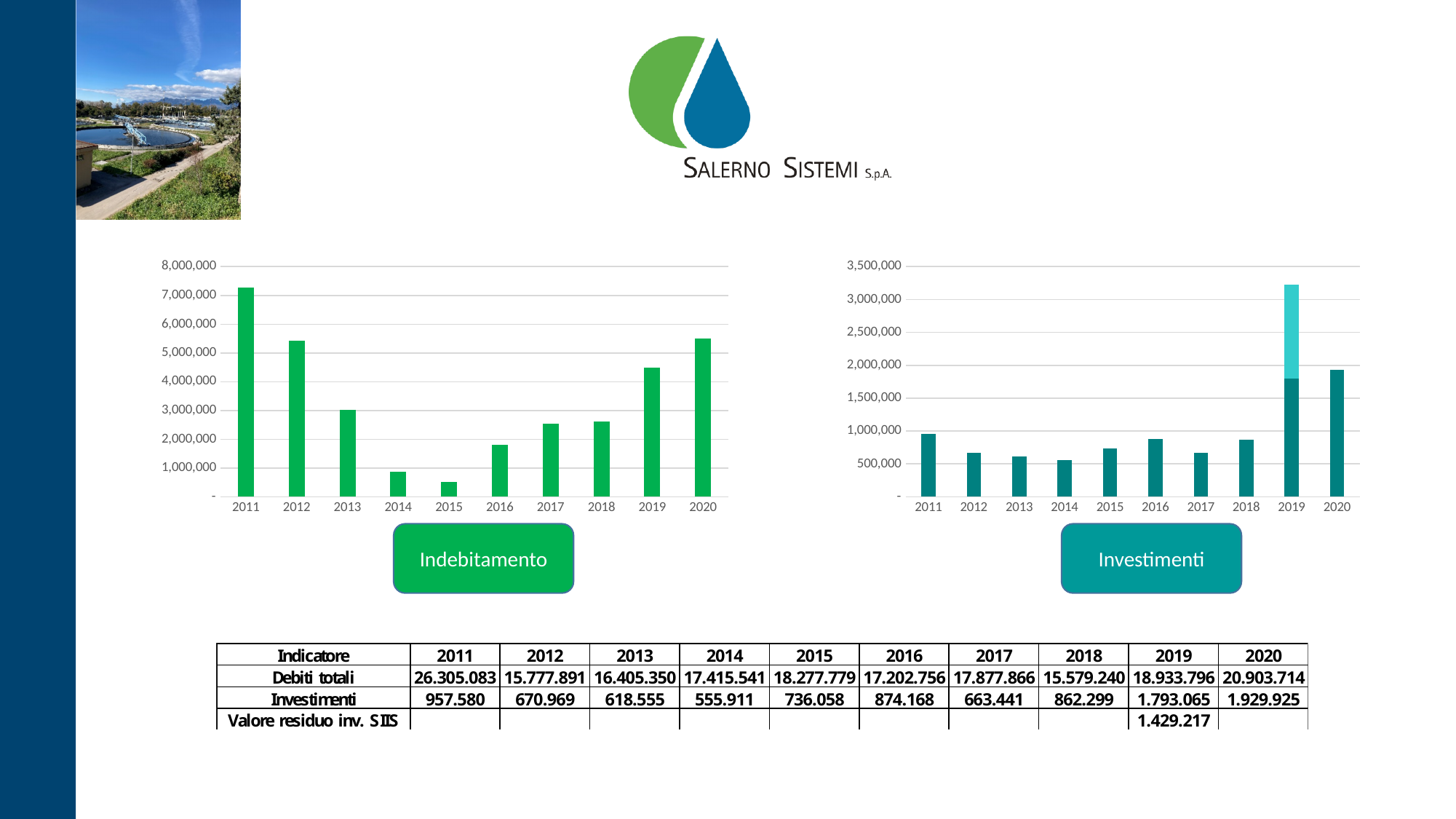
In the Investimenti chart, which is larger, the value for 2011 or the value for 2017? 2011 In the Indebitamento chart, is the value for 2014 greater or less than 1,000,000? less What kind of chart is the Indebitamento chart on the left? bar chart In the Investimenti chart, is the value for 2020 greater or less than 1,500,000? greater In the Indebitamento chart, is the value for 2011 greater or less than 7,000,000? greater In the Indebitamento chart, which is larger, the value for 2012 or the value for 2019? 2012 In the Indebitamento chart, which year has the lowest value? 2015 In the Investimenti chart, which year has the tallest bar? 2019 In the Investimenti chart, which year has the lowest value? 2014 How many years are shown on the x axis of the Indebitamento chart? 10 In the Indebitamento chart, which year has the highest value? 2011